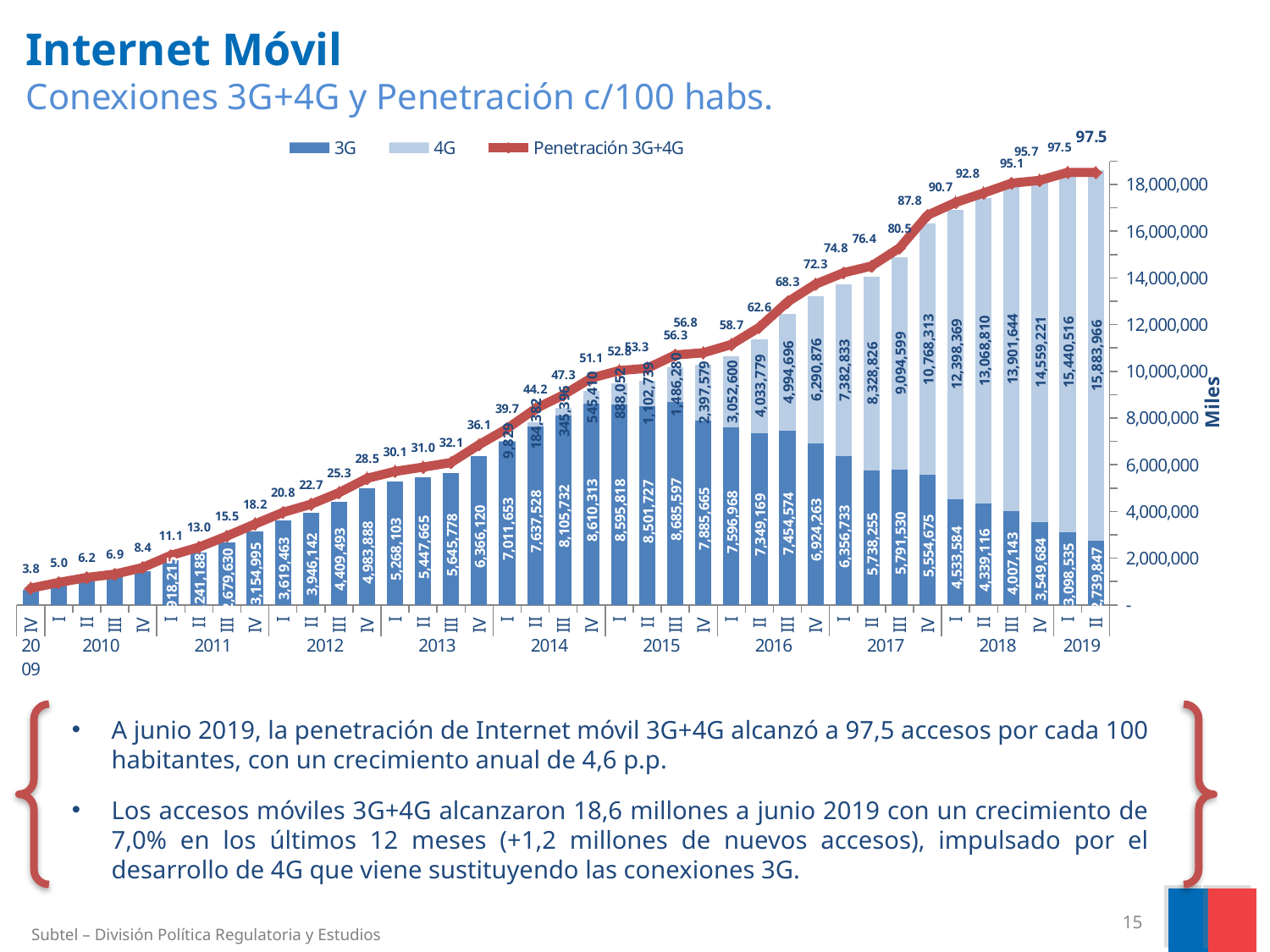
What is the highest Penetración 3G+4G value shown? 97.5 What is the total of the 3G and 4G segments for II 2019? 18,623,813 Does the Penetración 3G+4G line rise or fall from IV 2009 to II 2019? Rises What is the difference between the 4G value for II 2019 and the 4G value for I 2019? 443,450 What is the 4G value for IV 2018? 14,559,221 In II 2019, which is larger, the 3G value or the 4G value? 4G What is the 3G value for II 2019? 2,739,847 What is the Penetración 3G+4G value for II 2019? 97.5 What is the 4G value for II 2019? 15,883,966 How many series does the legend list? 3 What is the lowest Penetración 3G+4G value shown, and in which period? 3.8, IV 2009 What kind of chart is shown on the slide? A stacked bar chart combined with a line